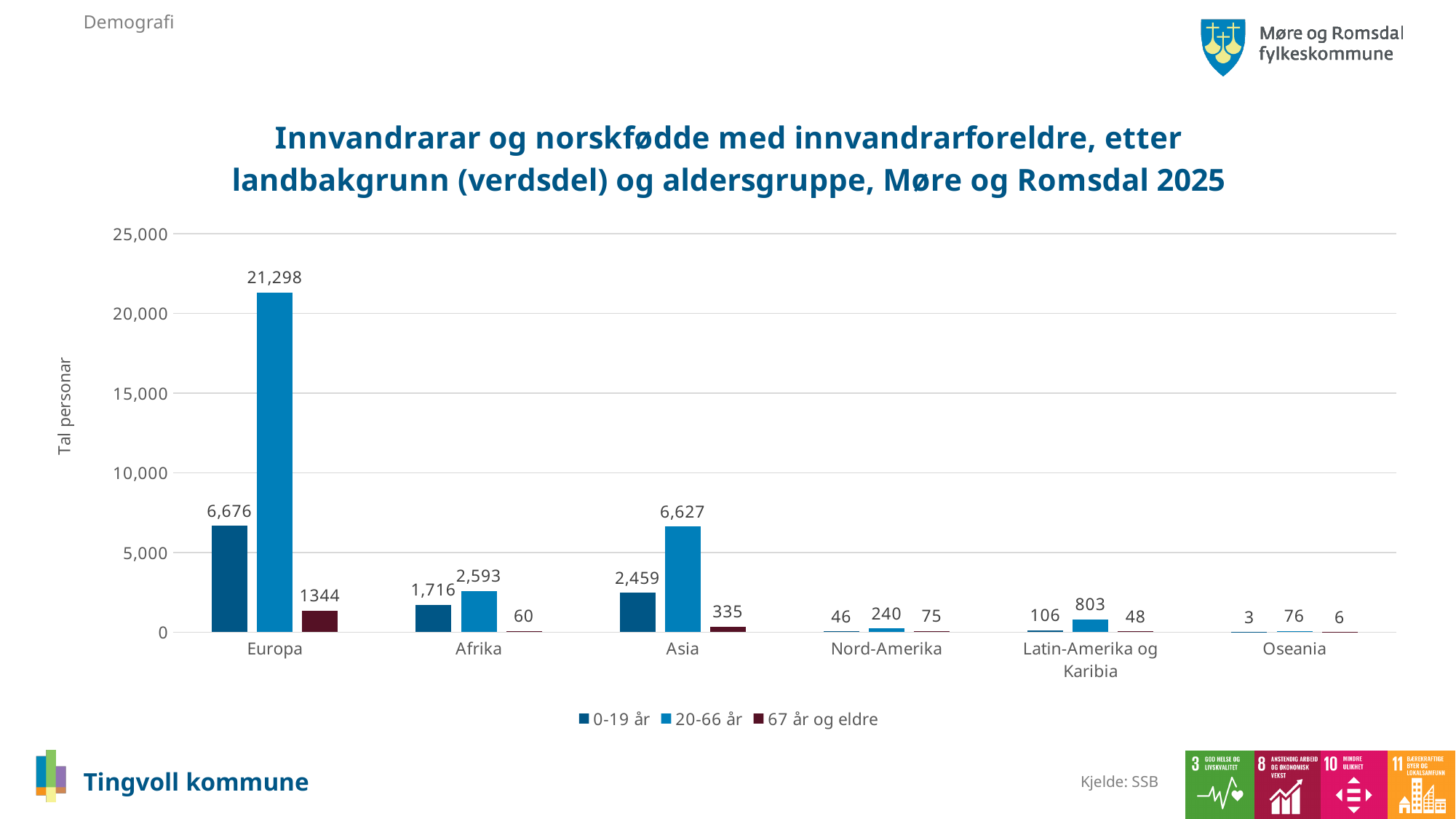
How many series does the legend list? 3 How many categories are shown on the x axis? 6 What is the difference between the 20-66 år and 0-19 år values for Europa? 14,622 What is the value for Asia in the 0-19 år series? 2,459 What is the difference between the 20-66 år values for Asia and Afrika? 4,034 What is the value for Europa in the 20-66 år series? 21,298 Which is larger: the 67 år og eldre value for Nord-Amerika or for Latin-Amerika og Karibia? Nord-Amerika Which category has the highest value in the 20-66 år series? Europa Which category has the lowest value in the 0-19 år series? Oseania What kind of chart is shown on the slide? Bar chart What is the value for Latin-Amerika og Karibia in the 20-66 år series? 803 What is the value for Afrika in the 67 år og eldre series? 60